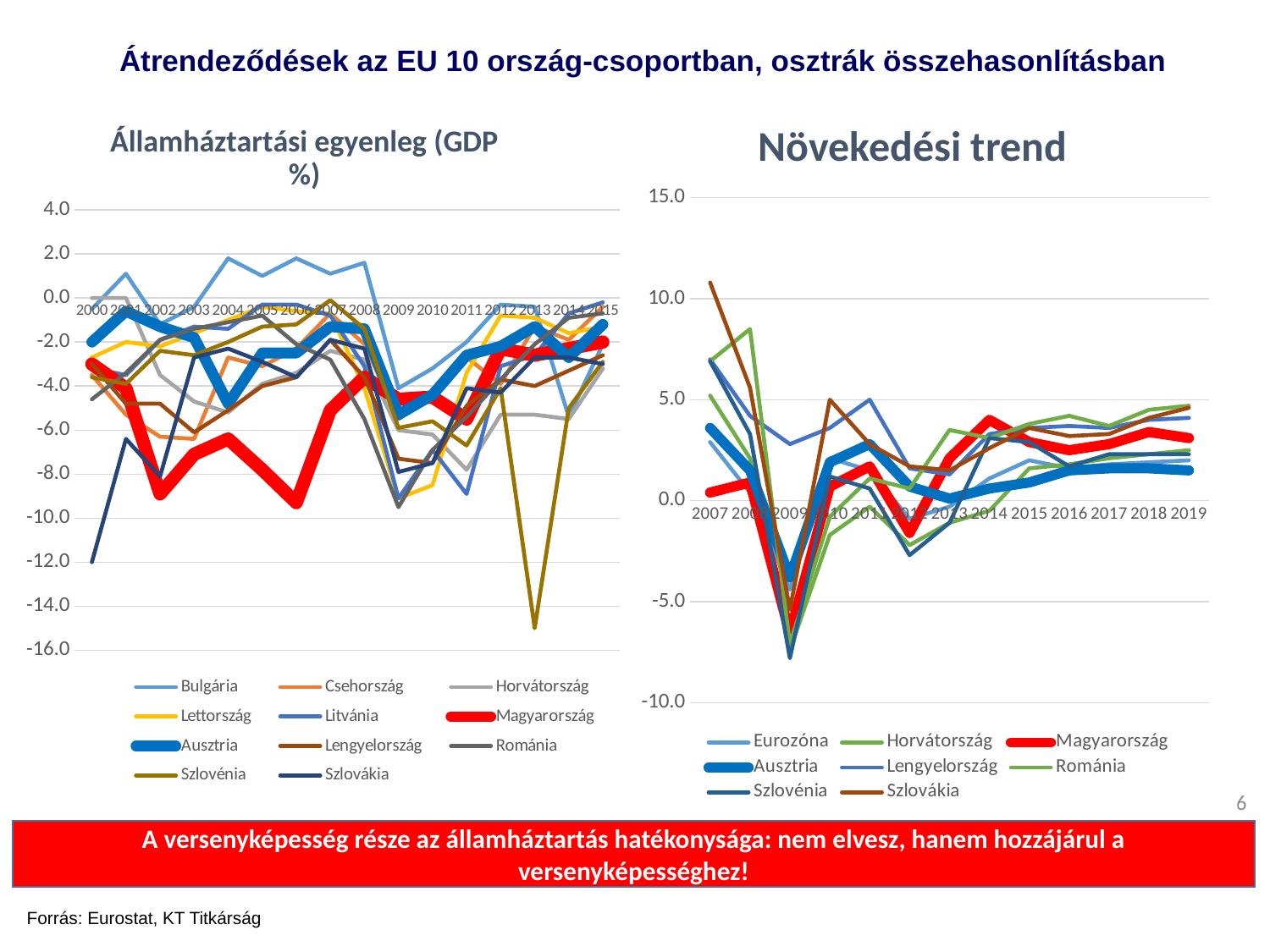
How many years are shown on the x axis of the "Növekedési trend" chart? 13 In the "Növekedési trend" chart, is the value for Magyarország in 2009 greater or less than -5.0? less How many years are shown on the x axis of the "Államháztartási egyenleg (GDP %)" chart? 16 What kind of chart is the "Növekedési trend" chart on the right? line chart What kind of chart is the "Államháztartási egyenleg (GDP %)" chart on the left? line chart In the "Államháztartási egyenleg (GDP %)" chart, is the value for Szlovénia in 2013 greater or less than -12.0? less How many series does the legend of the "Növekedési trend" chart list? 8 How many series does the legend of the "Államháztartási egyenleg (GDP %)" chart list? 11 In the "Növekedési trend" chart, is the value for Szlovákia in 2007 greater or less than 10.0? greater In the "Növekedési trend" chart, which series has the highest value in 2007? Szlovákia In the "Államháztartási egyenleg (GDP %)" chart, which series has the lowest value in 2013? Szlovénia What is the first year shown on the x axis of the "Növekedési trend" chart? 2007